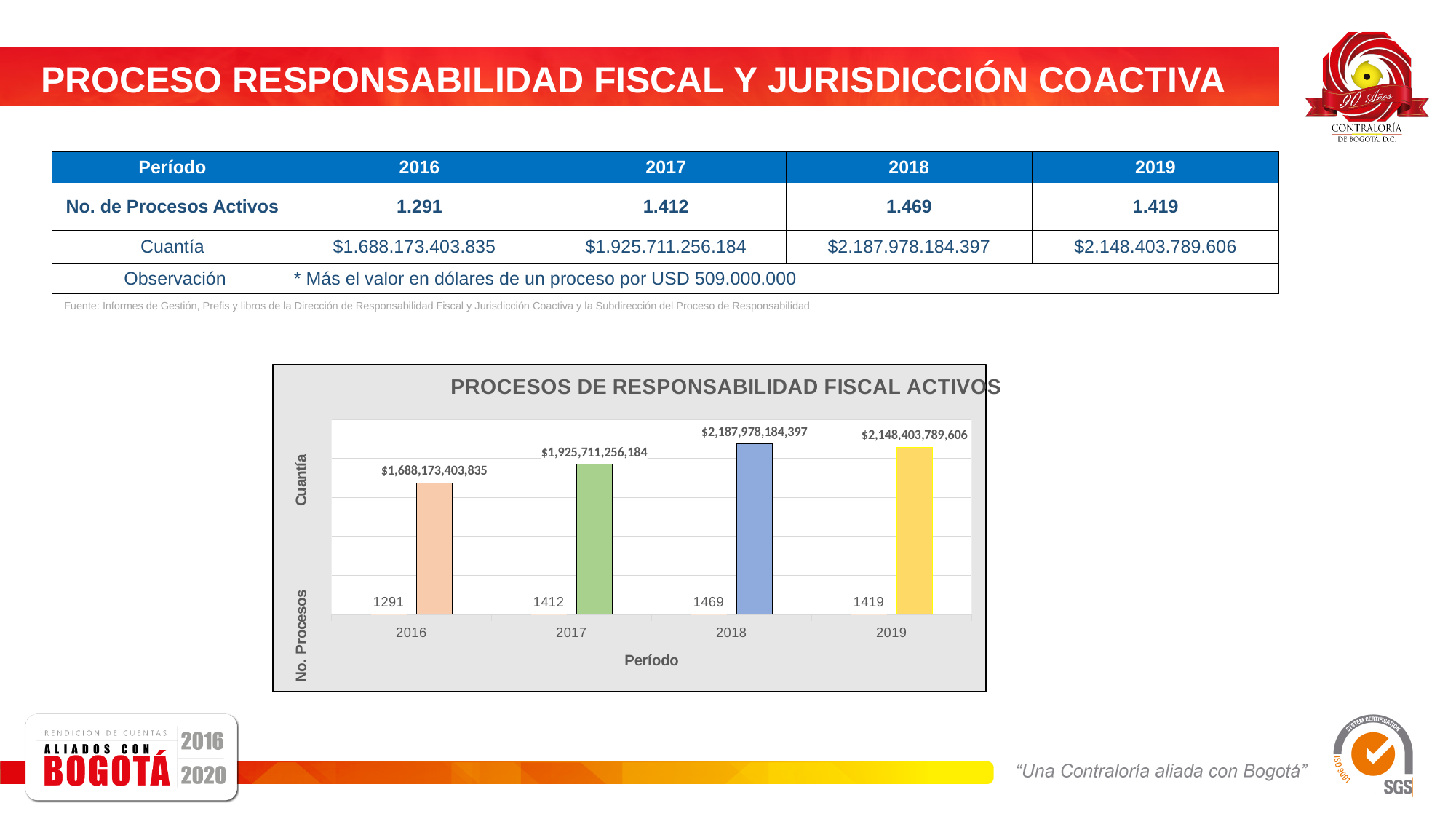
What is the Cuantía value labeled for 2016 in the chart? $1,688,173,403,835 What is the No. Procesos value labeled for 2019 in the chart? 1419 Which year has the lowest No. Procesos in the chart? 2016 What type of chart is shown on the slide? Bar chart Is the Cuantía for 2017 larger or smaller than the Cuantía for 2019 in the chart? Smaller What is the Cuantía value labeled for 2018 in the chart? $2,187,978,184,397 What is the title of the chart? PROCESOS DE RESPONSABILIDAD FISCAL ACTIVOS What is the No. Procesos value labeled for 2017 in the chart? 1412 How many periods (years) are shown on the x axis of the chart? 4 What is the difference in No. Procesos between 2018 and 2017 in the chart? 57 Which year has the highest Cuantía in the chart? 2018 How does the Cuantía change from 2016 to 2019 in the chart? It rises from 2016 to 2018, then falls in 2019